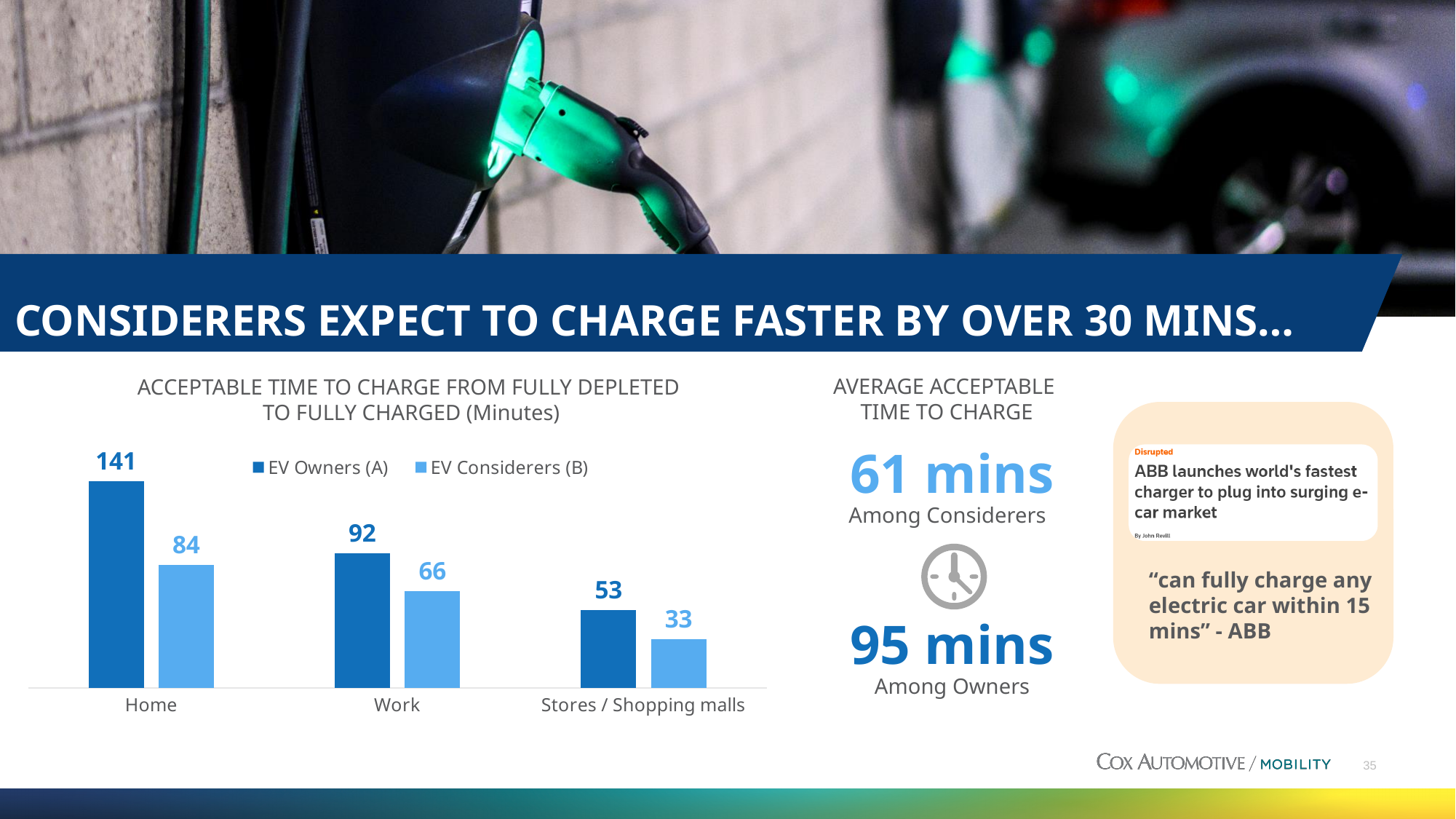
Which location has the highest acceptable charge time for EV Owners (A)? Home What is the difference between EV Owners (A) and EV Considerers (B) at Home? 57 Which is larger at Stores / Shopping malls: EV Owners (A) or EV Considerers (B)? EV Owners (A) What is the acceptable charge time for EV Considerers (B) at Work? 66 What kind of chart is shown on the slide? Bar chart How many locations are shown on the x axis of the chart? 3 How many series does the chart legend list? 2 Which location has the lowest acceptable charge time for EV Considerers (B)? Stores / Shopping malls Do the EV Owners (A) values rise or fall from Home to Stores / Shopping malls? Fall What is the acceptable charge time for EV Owners (A) at Home? 141 What is the acceptable charge time for EV Considerers (B) at Stores / Shopping malls? 33 What is the difference between EV Owners (A) and EV Considerers (B) at Work? 26